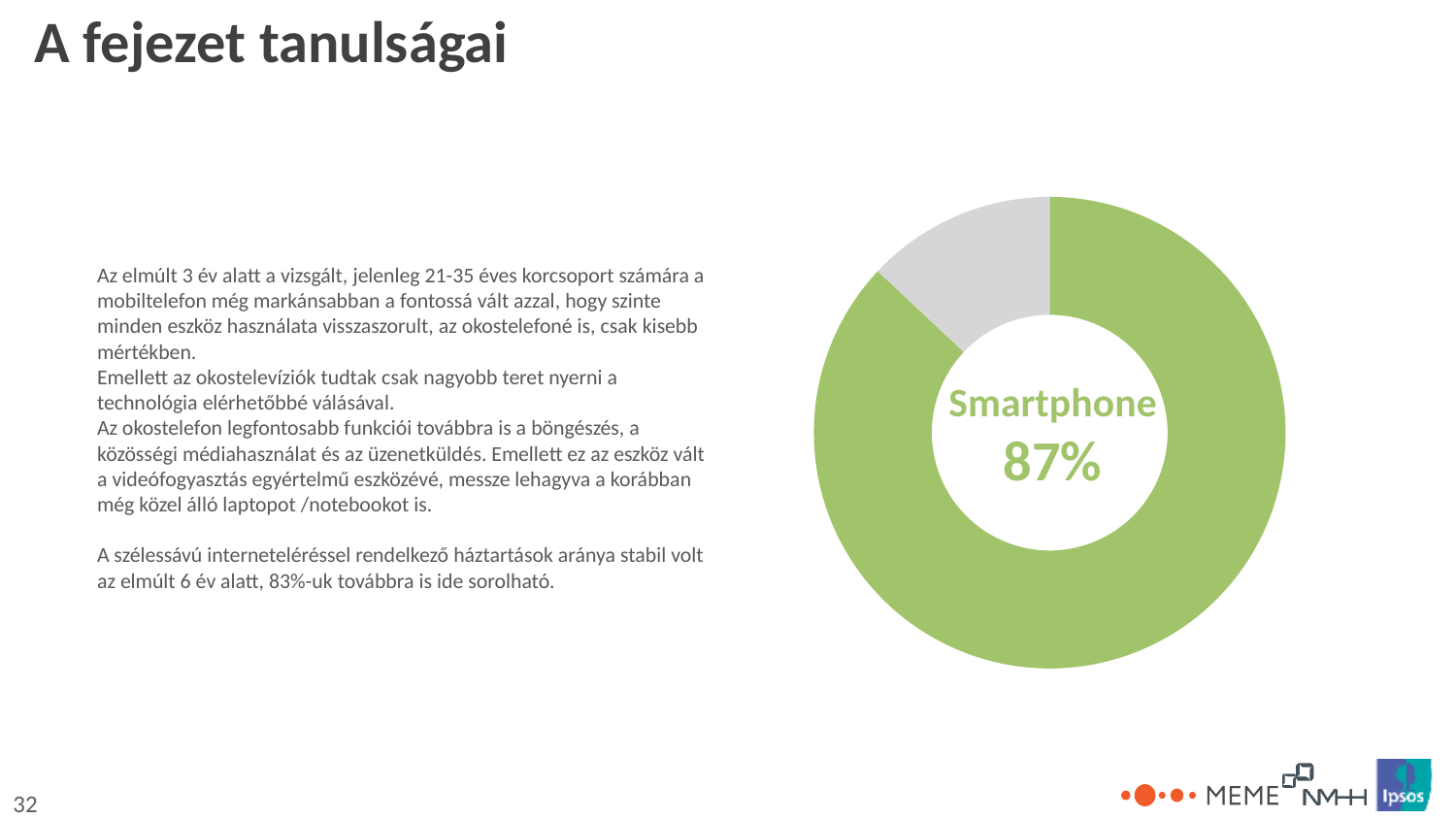
What kind of chart is shown on the slide? donut (pie) chart Which category is labelled in the centre of the donut chart? Smartphone How many slices does the donut chart have? 2 What colour is the Smartphone slice of the chart? green What share of the pie does the Smartphone slice represent? 87% Which slice of the chart is larger, the green one or the grey one? the green one Is the Smartphone slice greater or less than half of the chart? greater What percentage is shown for Smartphone in the chart? 87%